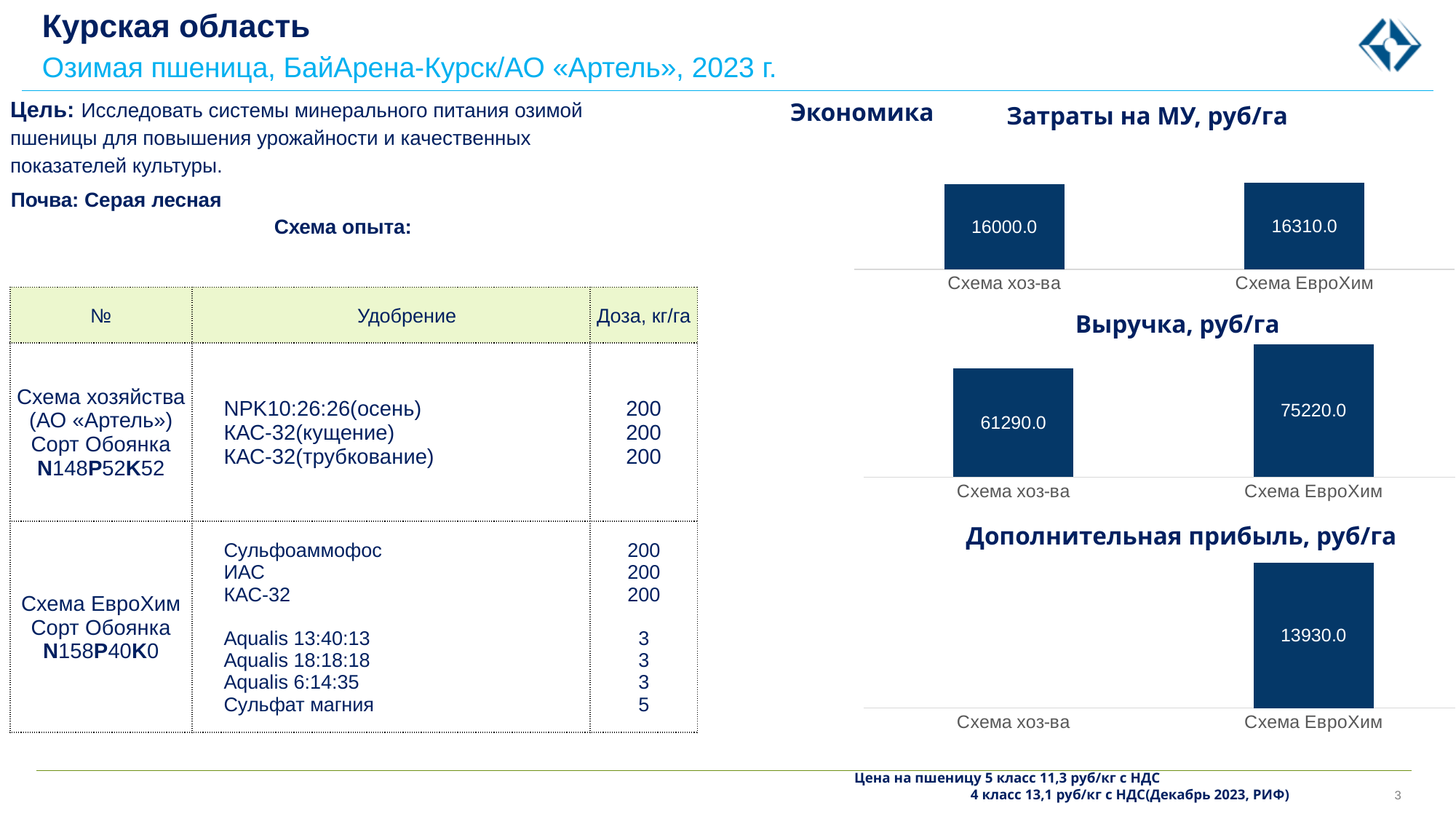
In the chart titled "Дополнительная прибыль, руб/га", what is the value for Схема ЕвроХим? 13930.0 How many charts are shown under the heading "Экономика" on the slide? 3 How many categories are shown on the x axis of the chart titled "Выручка, руб/га"? 2 In the chart titled "Выручка, руб/га", what is the difference between Схема ЕвроХим and Схема хоз-ва? 13930.0 In the chart titled "Затраты на МУ, руб/га", which is larger: Схема хоз-ва or Схема ЕвроХим? Схема ЕвроХим In the chart titled "Затраты на МУ, руб/га", what is the difference between Схема ЕвроХим and Схема хоз-ва? 310.0 In the chart titled "Выручка, руб/га", what is the value for Схема хоз-ва? 61290.0 What kind of chart is the chart titled "Затраты на МУ, руб/га"? bar chart In the chart titled "Выручка, руб/га", which category has the highest value? Схема ЕвроХим In the chart titled "Затраты на МУ, руб/га", what is the value for Схема хоз-ва? 16000.0 In the chart titled "Затраты на МУ, руб/га", what is the value for Схема ЕвроХим? 16310.0 In the chart titled "Выручка, руб/га", what is the value for Схема ЕвроХим? 75220.0